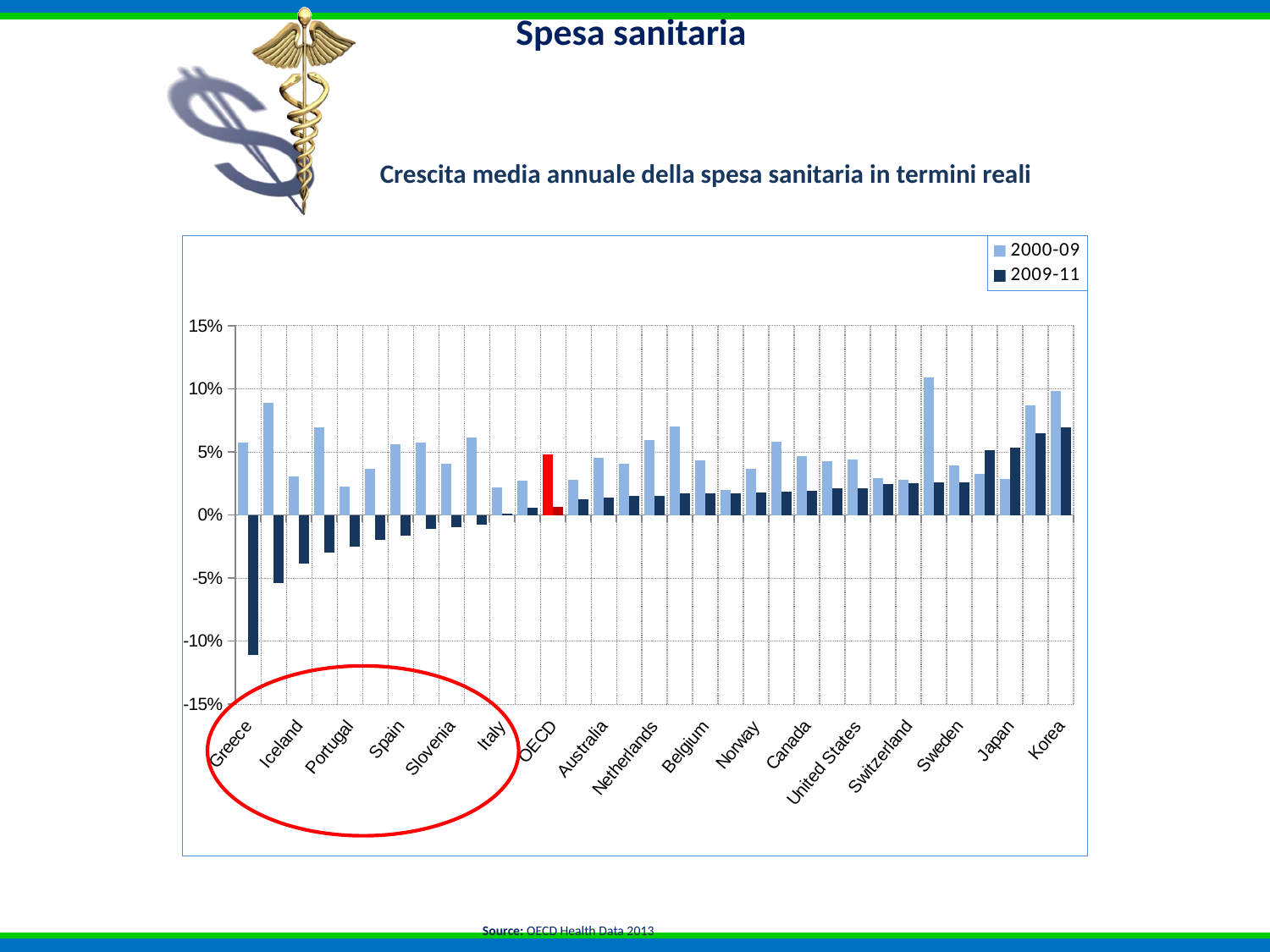
Is the 2009-11 value for Greece greater or less than -10%? less Which category has the lowest value for the 2009-11 series? Greece Is the 2009-11 value for Korea greater or less than 5%? greater How many series does the legend list? 2 Do the 2009-11 values generally rise or fall moving from left to right along the x axis? rise What kind of chart is shown on the slide? bar chart Is the 2009-11 value for Iceland greater or less than 0%? less Which two periods are listed in the legend? 2000-09 and 2009-11 For Japan, which series has the larger value, 2000-09 or 2009-11? 2009-11 Which category has the highest value for the 2009-11 series? Korea Which is larger, the 2000-09 value for Korea or the 2000-09 value for Greece? Korea